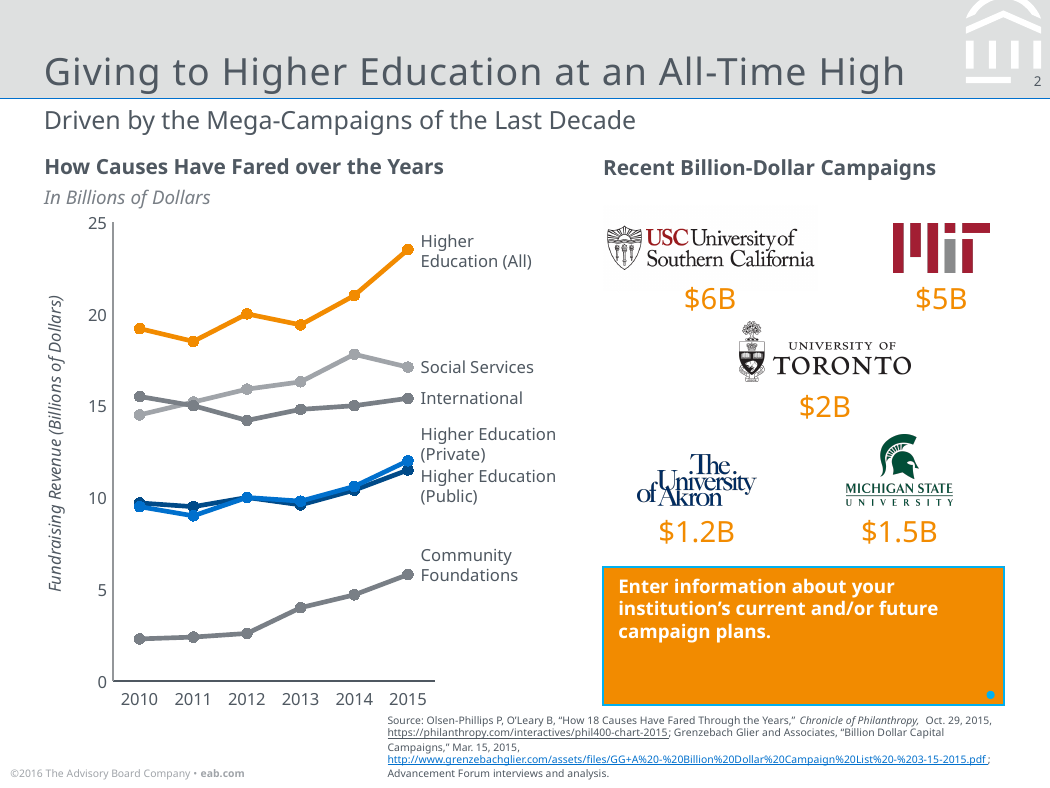
Is the value for Higher Education (All) in 2015 greater or less than 20? greater How many series (lines) are labeled on the "How Causes Have Fared over the Years" chart? 6 Which series has the highest value in 2015 on the "How Causes Have Fared over the Years" chart? Higher Education (All) How many years are plotted on the x axis of the "How Causes Have Fared over the Years" chart? 6 Which series has the lowest value in 2015 on the "How Causes Have Fared over the Years" chart? Community Foundations Is the value for Higher Education (Public) in 2011 greater or less than 10? less In 2014, which is larger: Social Services or International? Social Services What kind of chart is shown under "How Causes Have Fared over the Years"? line chart What unit is the y axis of the "How Causes Have Fared over the Years" chart measured in? Billions of Dollars Does the Community Foundations line rise or fall from 2010 to 2015? rise Is the value for Social Services in 2014 greater or less than 15? greater